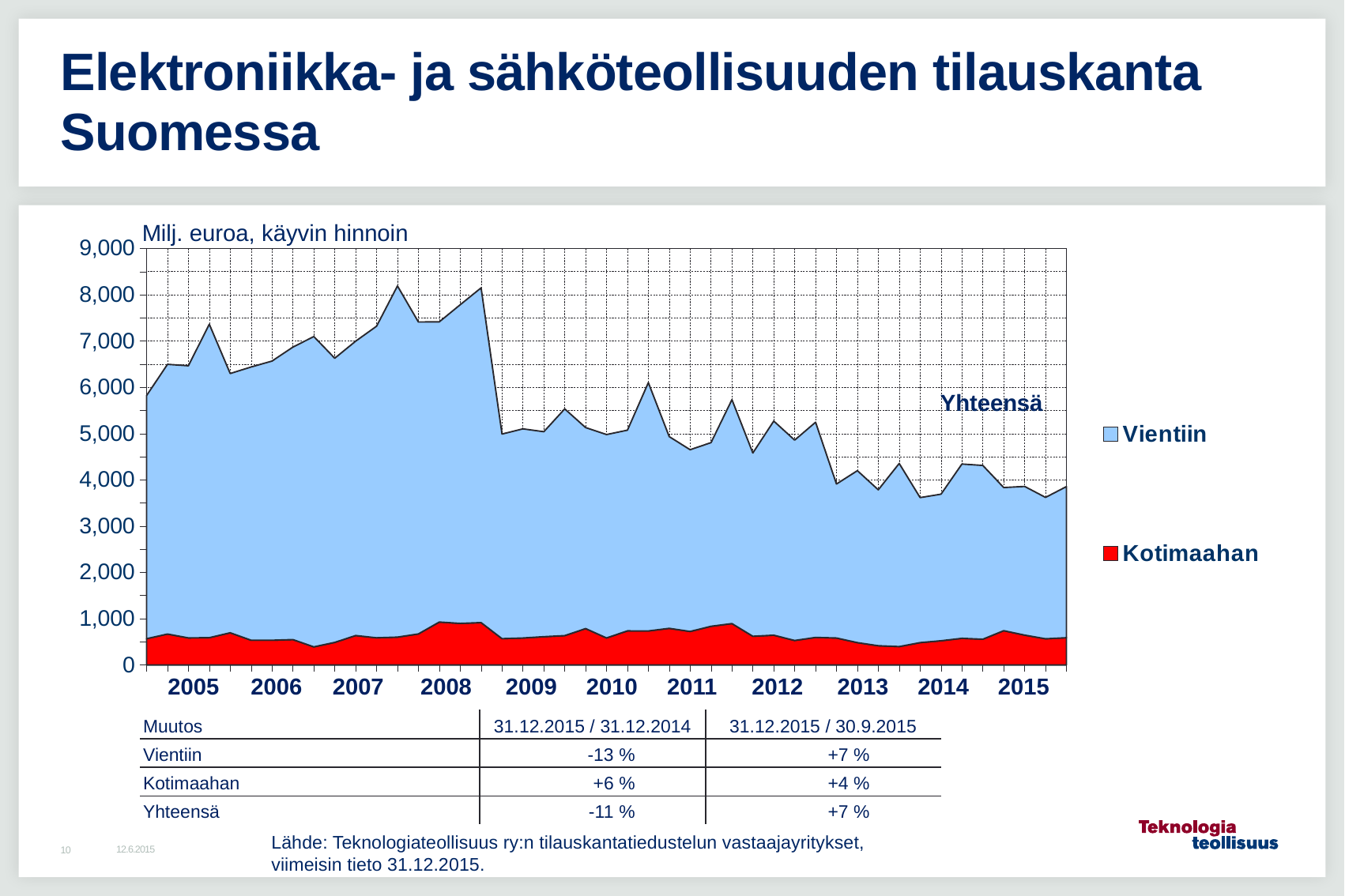
Does the total (Yhteensä) value rise or fall between 2008 and 2009? fall Which series is shown in red? Kotimaahan Is the total (Yhteensä) value at the end of 2015 greater or less than 5,000? less What are the two series named in the legend? Vientiin and Kotimaahan How many series does the legend list? 2 Is the Kotimaahan value in 2008 greater or less than 1,000? less Which series is larger throughout the chart, Vientiin or Kotimaahan? Vientiin Overall, does the total (Yhteensä) value rise or fall from 2005 to 2015? fall How many year labels are shown on the x axis? 11 Is the total (Yhteensä) value at the start of 2005 greater or less than 5,000? greater What kind of chart is shown on the slide? area chart